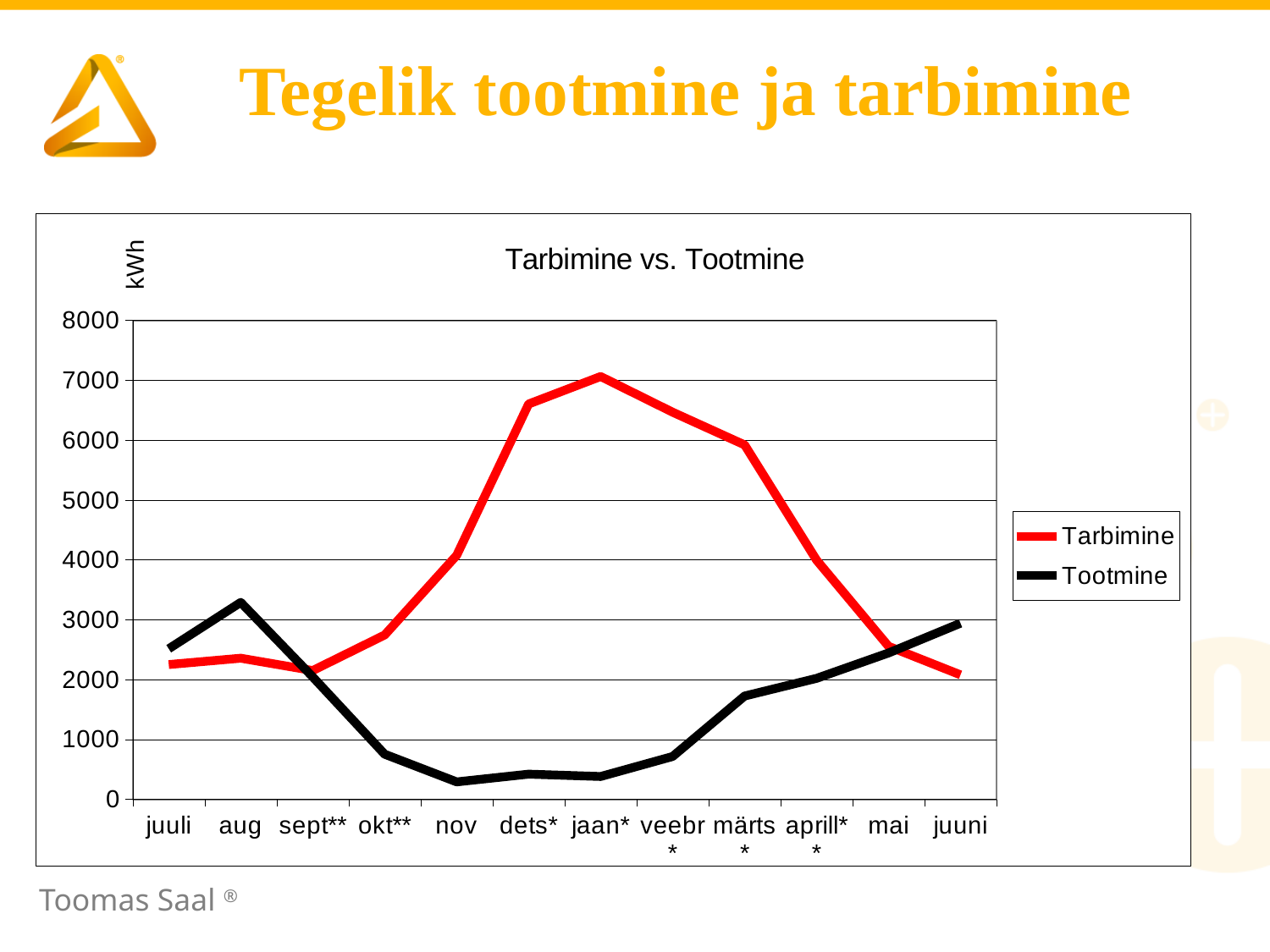
How many months are shown on the x axis? 12 What kind of chart is shown on the slide? line chart Is the value for Tarbimine in jaan* greater or less than 6000? greater How many series does the legend list? 2 Which series has the larger value in jaan*, Tarbimine or Tootmine? Tarbimine Which series has the larger value in aug, Tarbimine or Tootmine? Tootmine In which month does the Tarbimine series reach its highest value? jaan* Does the Tarbimine series rise or fall from juuli to jaan*? rise Is the value for Tootmine in nov greater or less than 1000? less Is the value for Tarbimine in juuni greater or less than 3000? less What is the title of the chart? Tarbimine vs. Tootmine In which month does the Tootmine series reach its lowest value? nov